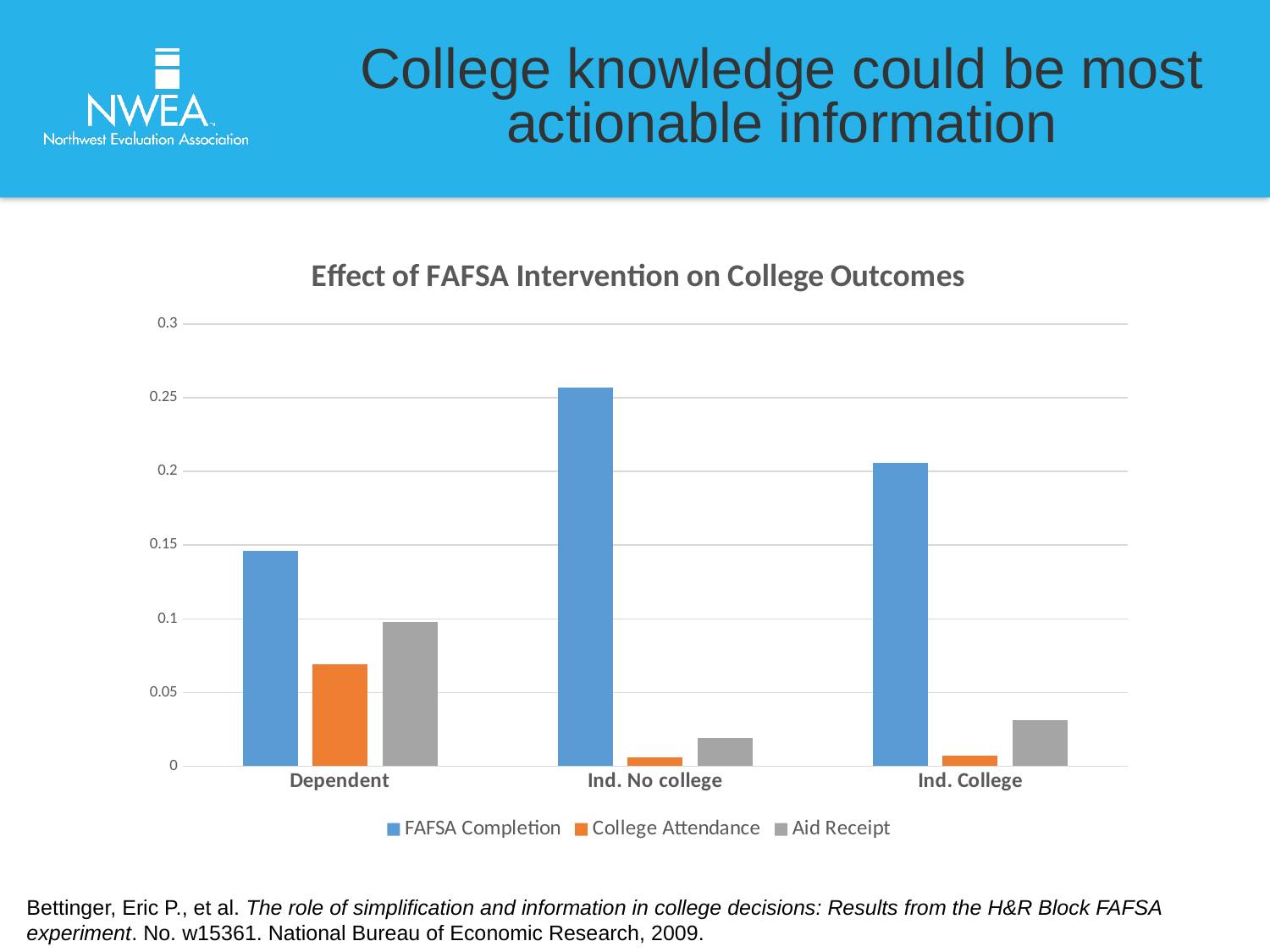
Is the FAFSA Completion value for Ind. No college greater or less than 0.2? greater Which is larger: the FAFSA Completion value for Ind. College or for Dependent? Ind. College What is the title of the chart? Effect of FAFSA Intervention on College Outcomes Which category has the highest FAFSA Completion value? Ind. No college Is the Aid Receipt value for Ind. No college greater or less than 0.05? less How many series does the chart legend list? 3 Is the FAFSA Completion value for Dependent greater or less than 0.1? greater For the Dependent category, which is larger: College Attendance or Aid Receipt? Aid Receipt What type of chart is shown on the slide? Bar chart How many categories are shown on the x axis of the chart? 3 Which category has the lowest Aid Receipt value? Ind. No college